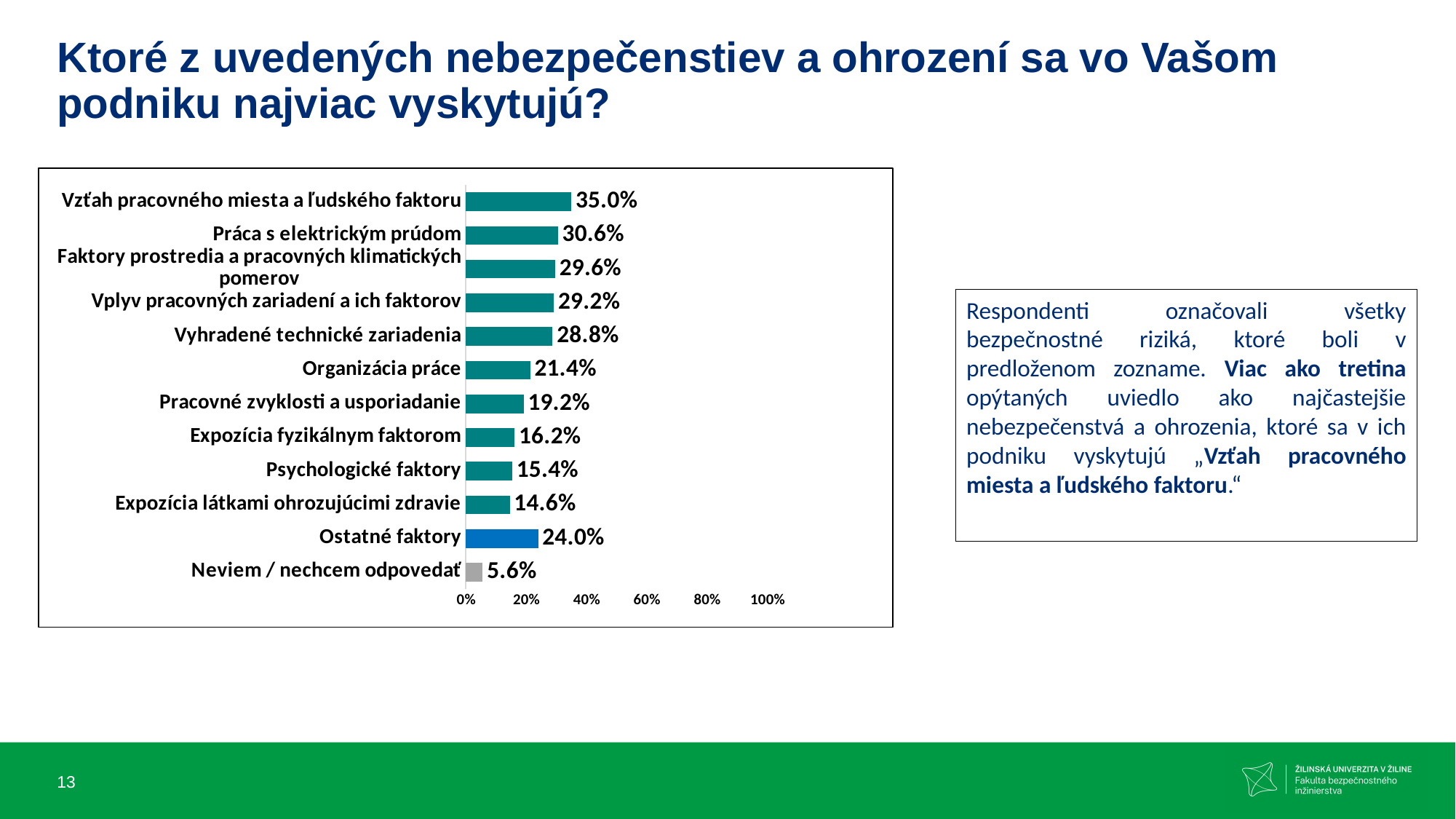
Which category has the lowest value? Neviem / nechcem odpovedať Which category has the highest value? Vzťah pracovného miesta a ľudského faktoru How many categories are shown in the chart? 12 What value is shown for "Vzťah pracovného miesta a ľudského faktoru"? 35.0% What kind of chart is shown on the slide? Bar chart What value is shown for "Práca s elektrickým prúdom"? 30.6% Is the value for "Expozícia látkami ohrozujúcimi zdravie" greater or less than 20%? less What colour is the bar for "Ostatné faktory"? Blue What value is shown for "Ostatné faktory"? 24.0% What is the difference between the values for "Vzťah pracovného miesta a ľudského faktoru" and "Práca s elektrickým prúdom"? 4.4 percentage points Which is larger: the value for "Ostatné faktory" or for "Organizácia práce"? Ostatné faktory What value is shown for "Psychologické faktory"? 15.4%